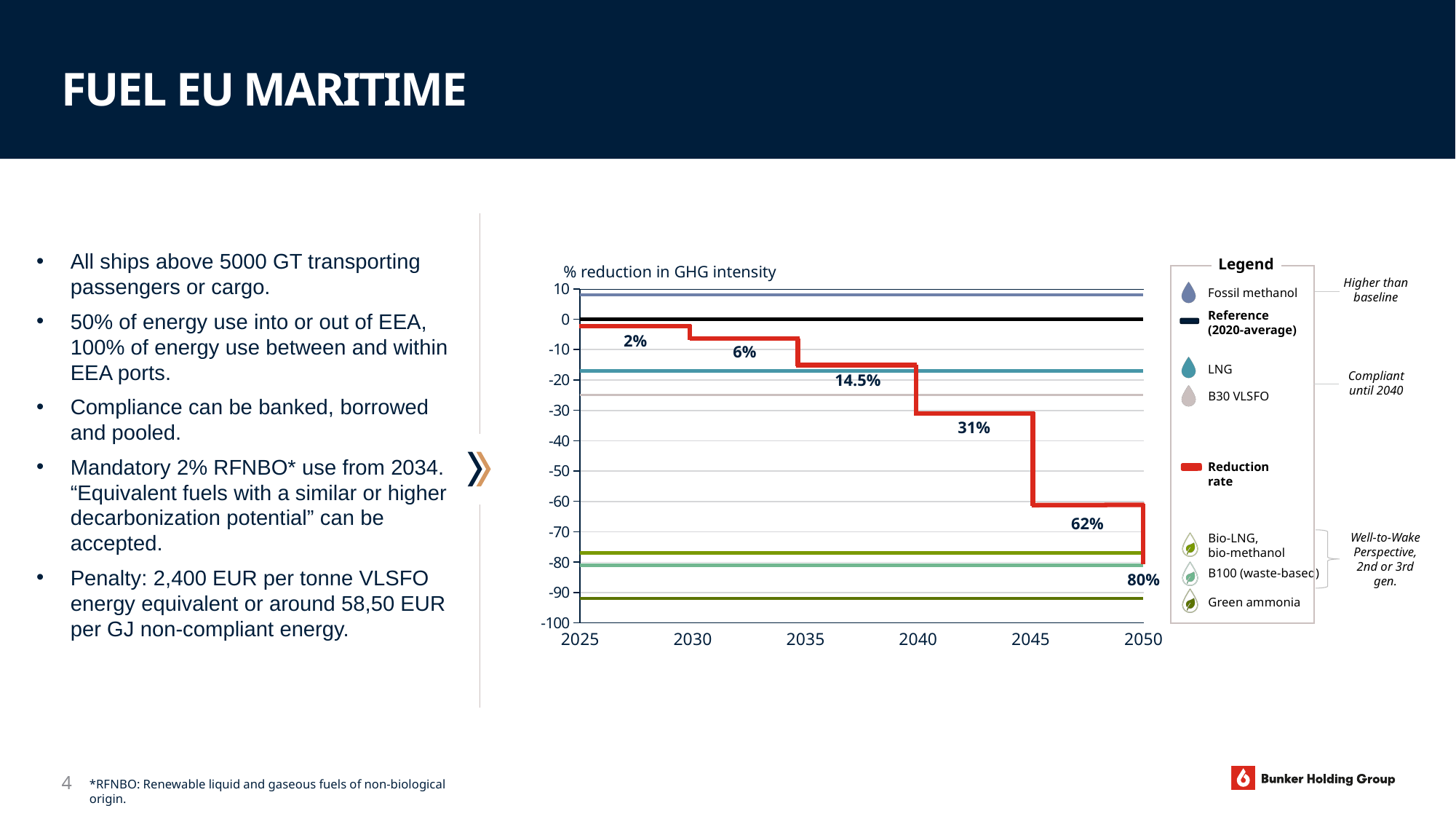
Is the value of the LNG line greater or less than -10? less What reduction rate is labelled on the step between 2035 and 2040? 14.5% What reduction rate is labelled on the step between 2040 and 2045? 31% Do the labelled reduction rate percentages increase or decrease from 2025 to 2050? increase What reduction rate is labelled on the step between 2030 and 2035? 6% How many reduction rate values are labelled on the red step line? 6 What reduction rate is labelled at 2050? 80% What is the title of the chart? % reduction in GHG intensity What kind of chart is shown on the slide? line chart What is the difference between the reduction rate labelled for 2045-2050 (62%) and the one for 2040-2045 (31%)? 31 percentage points What is the largest reduction rate labelled on the chart? 80% What is the smallest reduction rate labelled on the chart? 2%